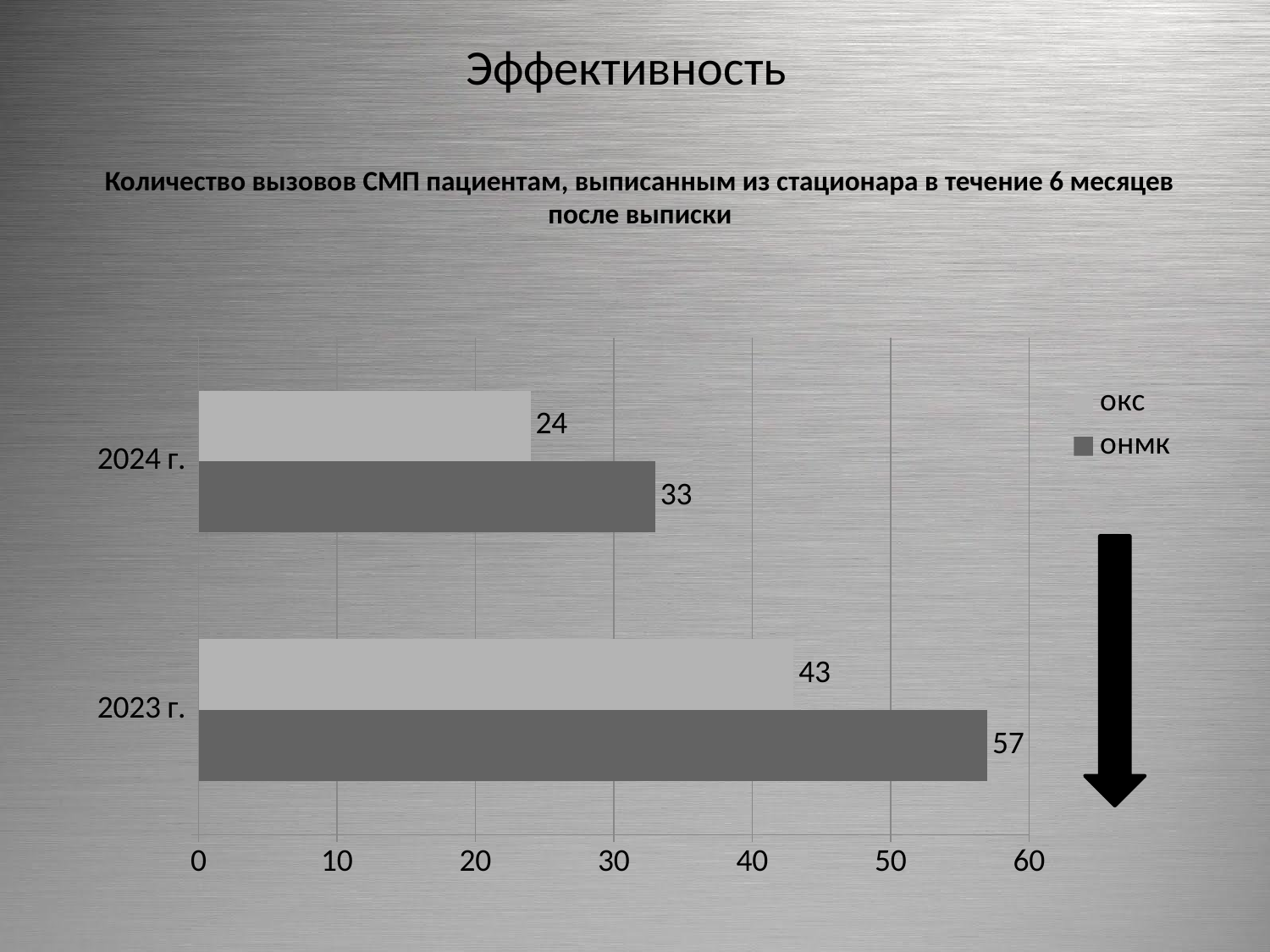
What is the value for ОКС in 2023 г.? 43 What is the value for ОНМК in 2023 г.? 57 What is the difference between the ОНМК values for 2023 г. and 2024 г.? 24 What kind of chart is shown on the slide? Bar chart What is the difference between the ОКС values for 2023 г. and 2024 г.? 19 What is the value for ОКС in 2024 г.? 24 What is the value for ОНМК in 2024 г.? 33 How many year categories are shown on the chart? 2 Which bar has the highest value on the chart? ОНМК, 2023 г. Which bar has the lowest value on the chart? ОКС, 2024 г. How many series does the legend list? 2 Which is larger: the ОКС value for 2023 г. or the ОНМК value for 2024 г.? ОКС value for 2023 г.